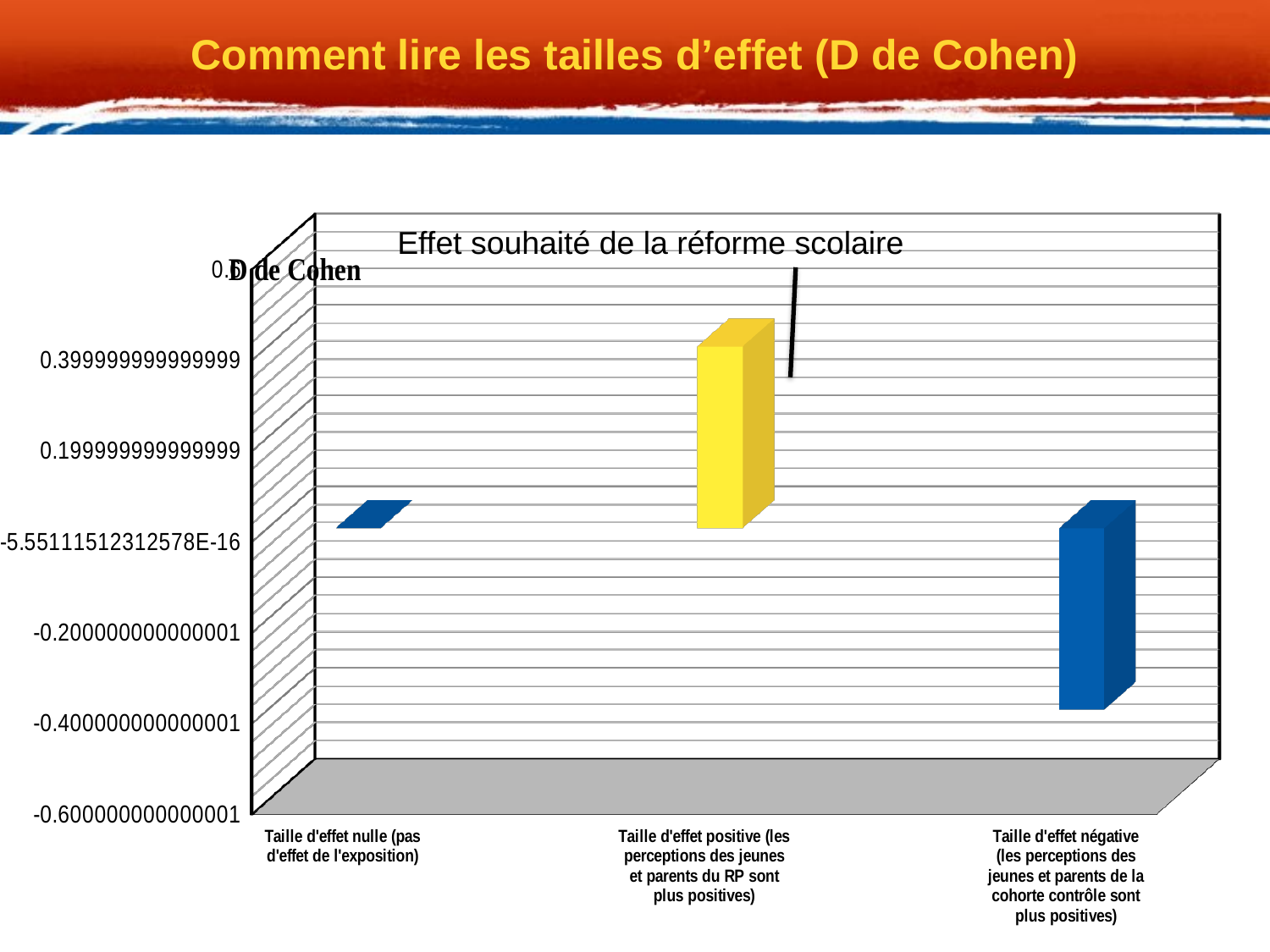
Is the value for 'Taille d'effet positive' greater or less than 0.2? greater Which is larger, the value for 'Taille d'effet nulle' or the value for 'Taille d'effet négative'? Taille d'effet nulle Is the value for 'Taille d'effet négative' greater or less than -0.2? less Is the value for 'Taille d'effet nulle' greater or less than 0.2? less Which category has the lowest value on the chart? Taille d'effet négative (les perceptions des jeunes et parents de la cohorte contrôle sont plus positives) How many categories are plotted on the chart? 3 Which category has the highest value on the chart? Taille d'effet positive (les perceptions des jeunes et parents du RP sont plus positives) What kind of chart is shown on the slide? bar chart Which is larger, the value for 'Taille d'effet positive' or the value for 'Taille d'effet nulle'? Taille d'effet positive What colour is the bar for 'Taille d'effet positive'? yellow